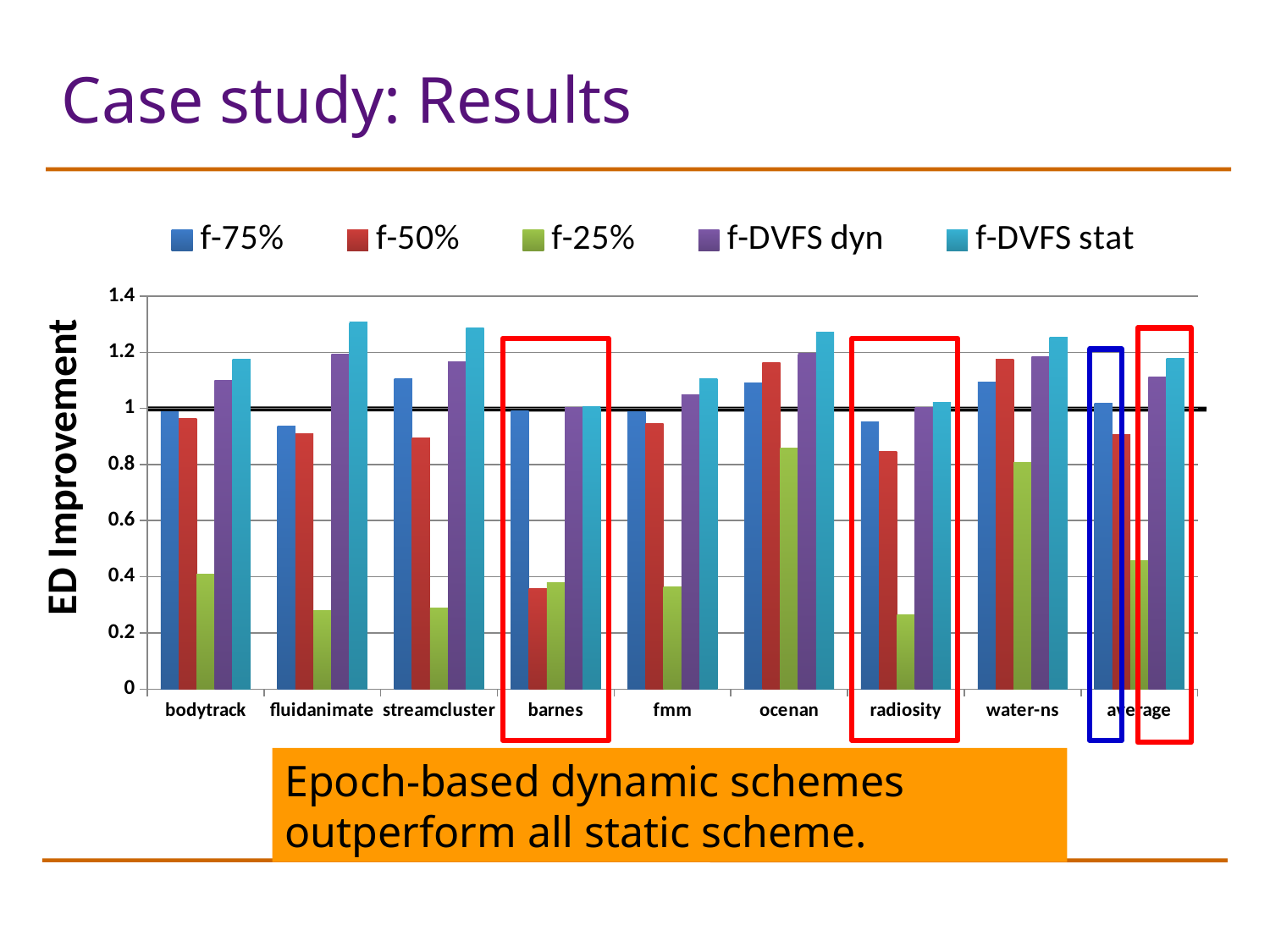
How many series does the legend list? 5 What kind of chart is shown on the slide? bar chart Is the f-DVFS dyn value for water-ns greater or less than 1? greater Is the f-25% value for bodytrack greater or less than 0.6? less For bodytrack, which is larger: the f-75% value or the f-DVFS stat value? f-DVFS stat How many categories are shown along the x axis? 9 What is the label of the y axis? ED Improvement Which colour represents the f-25% series in the legend? green Is the f-25% value for radiosity greater or less than 0.4? less For ocenan, which series has the highest value? f-DVFS stat For bodytrack, which series has the lowest value? f-25%